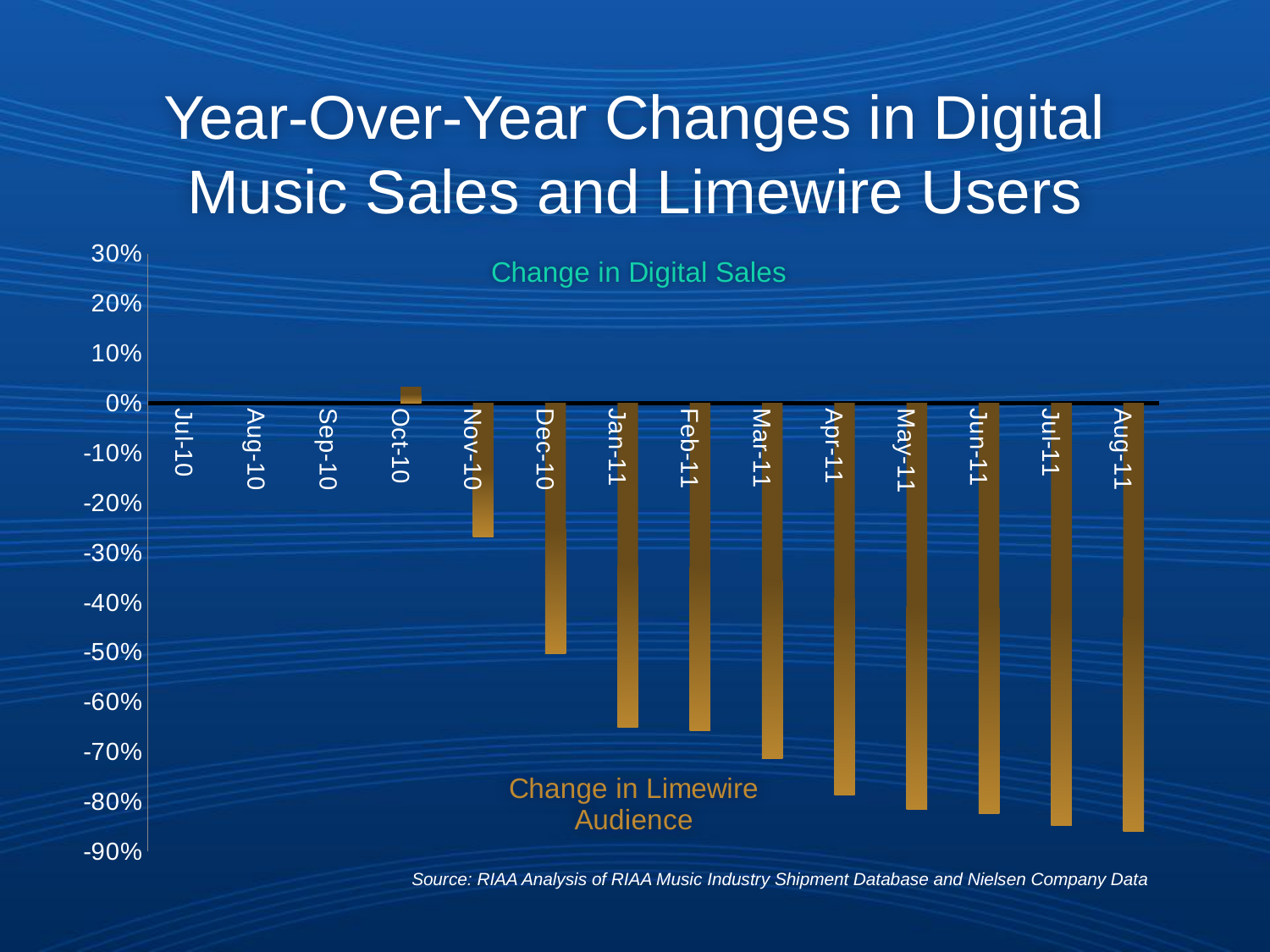
Is the value for Change in Limewire Audience in Dec-10 greater or less than -40%? less How many months are shown along the x axis of the chart? 14 Is the value for Change in Limewire Audience in Nov-10 greater or less than -20%? less What kind of chart is shown on the slide? bar chart What is the title of the chart on the slide? Year-Over-Year Changes in Digital Music Sales and Limewire Users Is the value for Change in Limewire Audience in Apr-11 greater or less than -70%? less Do the Change in Limewire Audience values rise or fall from Oct-10 to Aug-11? fall Which is larger, the Change in Limewire Audience for Jan-11 or for Mar-11? Jan-11 Which is larger, the Change in Limewire Audience for Nov-10 or for Dec-10? Nov-10 Which month has the highest value for Change in Limewire Audience? Oct-10